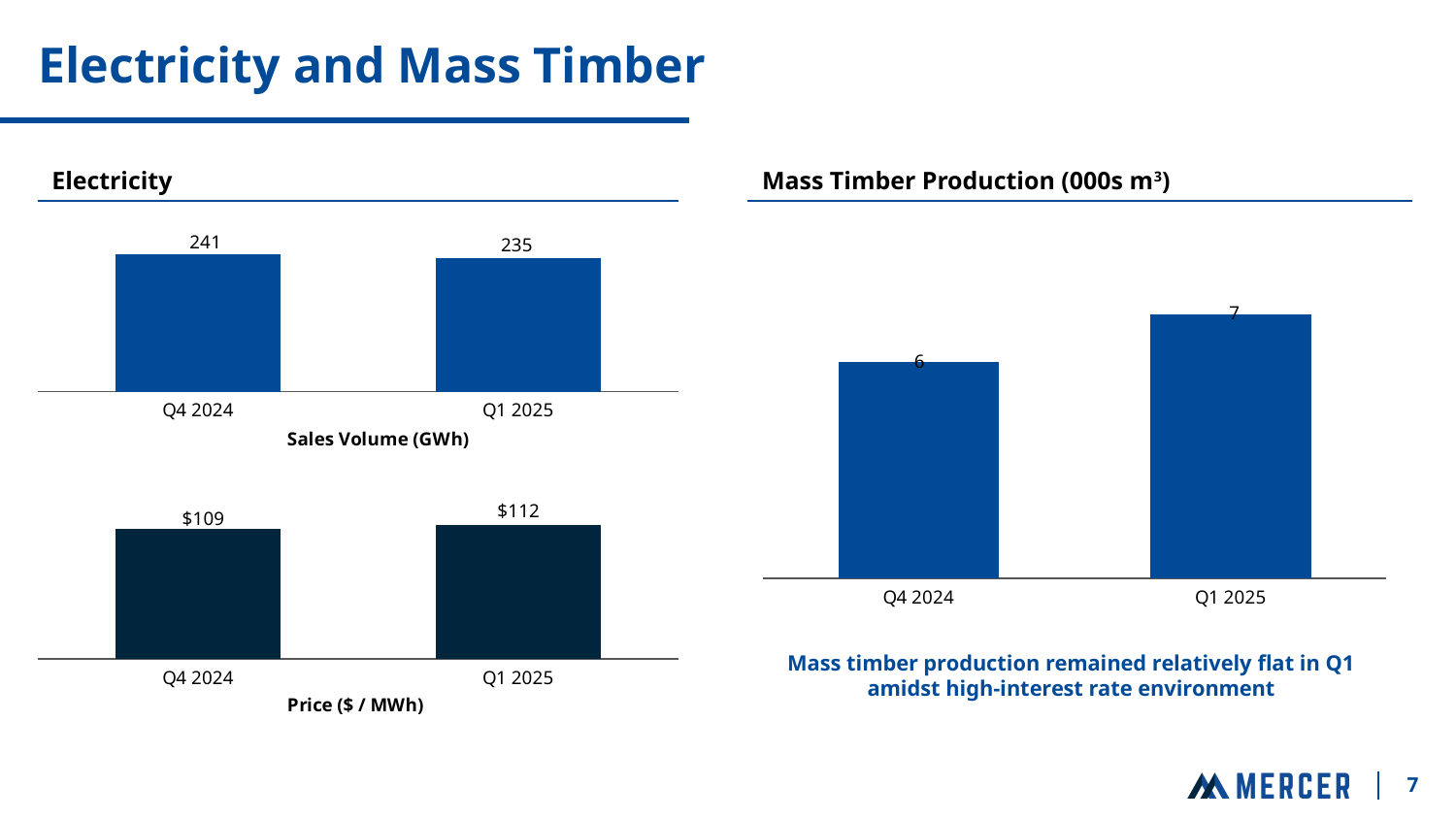
In the Electricity Price ($ / MWh) chart, which quarter has the higher price? Q1 2025 In the Electricity Sales Volume (GWh) chart, which quarter has the lower sales volume? Q1 2025 In the Electricity Price ($ / MWh) chart, what is the value for Q1 2025? $112 In the Electricity Sales Volume (GWh) chart, what is the value for Q4 2024? 241 In the Electricity Sales Volume (GWh) chart, what is the difference between Q4 2024 and Q1 2025? 6 In the Mass Timber Production (000s m³) chart, do values rise or fall from Q4 2024 to Q1 2025? rise In the Electricity Sales Volume (GWh) chart, what is the value for Q1 2025? 235 In the Mass Timber Production (000s m³) chart, what is the value for Q1 2025? 7 What kind of chart is the Electricity Price ($ / MWh) chart? bar chart In the Mass Timber Production (000s m³) chart, what is the value for Q4 2024? 6 In the Electricity Price ($ / MWh) chart, what is the value for Q4 2024? $109 How many categories are shown in the Mass Timber Production (000s m³) chart? 2